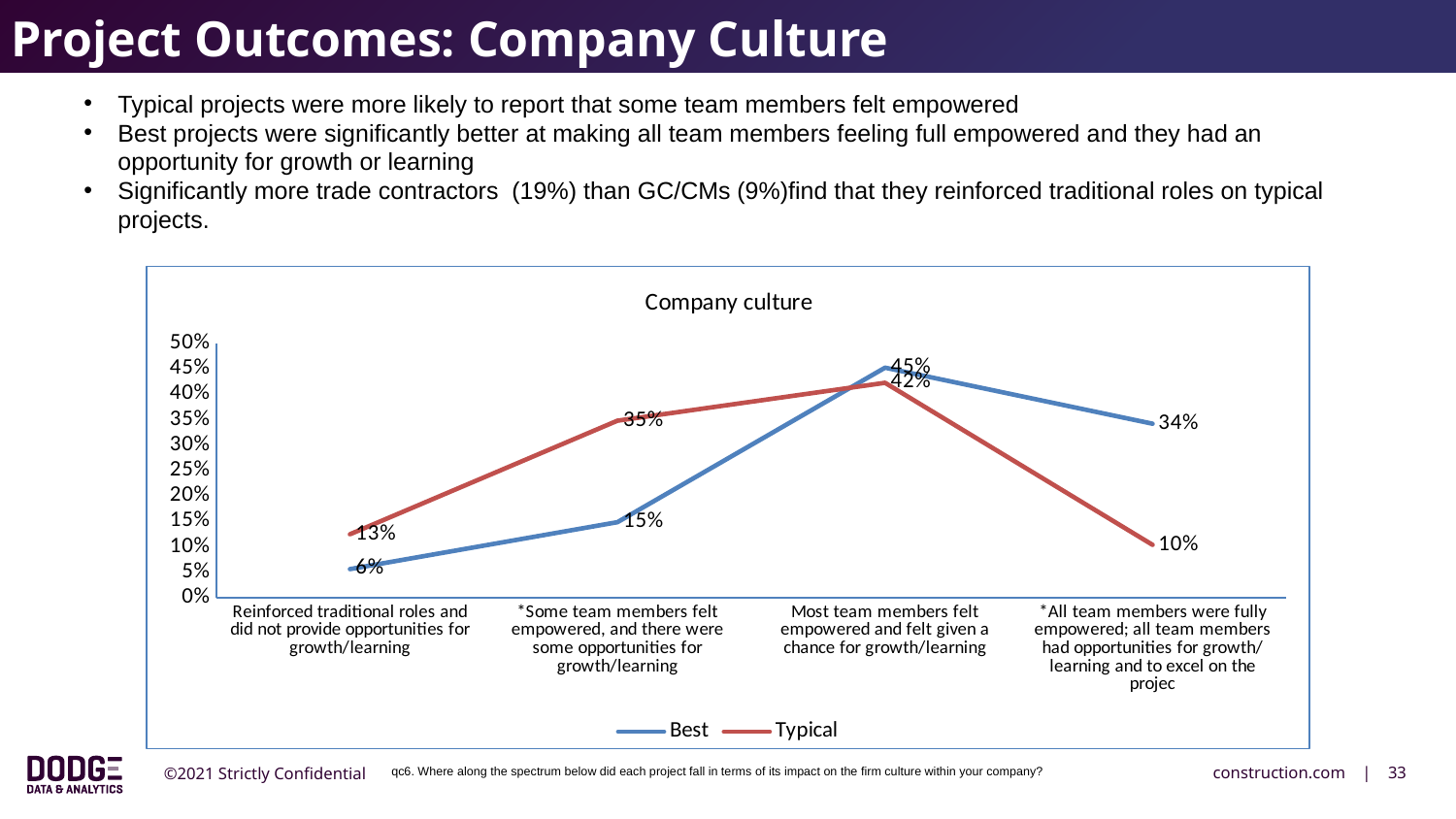
How many series does the legend list? 2 Which series is drawn in red? Typical What is the value for Best for 'Most team members felt empowered and felt given a chance for growth/learning'? 45% What is the title of the chart? Company culture Which series has the larger value for 'Some team members felt empowered, and there were some opportunities for growth/learning', Best or Typical? Typical How many categories are shown on the x axis? 4 What is the value for Best for 'All team members were fully empowered; all team members had opportunities for growth/learning and to excel on the projec'? 34% What type of chart is shown on the slide? line chart Which category has the lowest value for the Best series? Reinforced traditional roles and did not provide opportunities for growth/learning What is the difference between Best and Typical for 'All team members were fully empowered; all team members had opportunities for growth/learning and to excel on the projec'? 24% What is the value for Typical for 'Reinforced traditional roles and did not provide opportunities for growth/learning'? 13% Which category has the highest value for the Typical series? Most team members felt empowered and felt given a chance for growth/learning